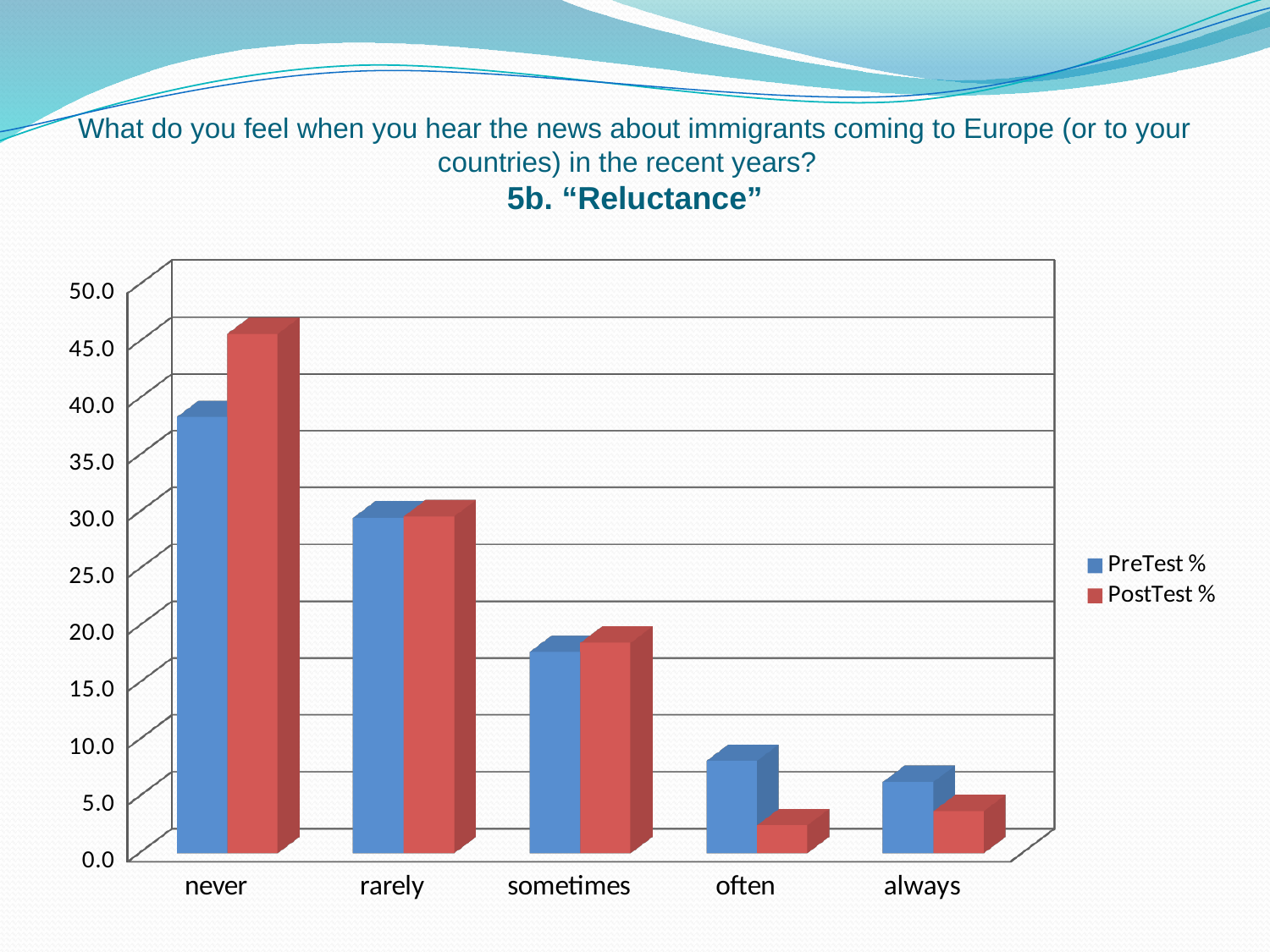
For the category 'often', which is larger: PreTest % or PostTest %? PreTest % Do the PreTest % values rise or fall moving from 'never' to 'always' along the x axis? fall What kind of chart is shown on the slide? bar chart Is the PostTest % value for 'never' greater or less than 40.0? greater What are the two series names listed in the legend? PreTest % and PostTest % Which category has the lowest PostTest % value? often Is the PreTest % value for 'rarely' greater or less than 35.0? less How many categories are shown on the x axis? 5 How many series does the legend list? 2 Is the PostTest % value for 'often' greater or less than 5.0? less Which category has the highest PreTest % value? never For the category 'never', which is larger: PreTest % or PostTest %? PostTest %